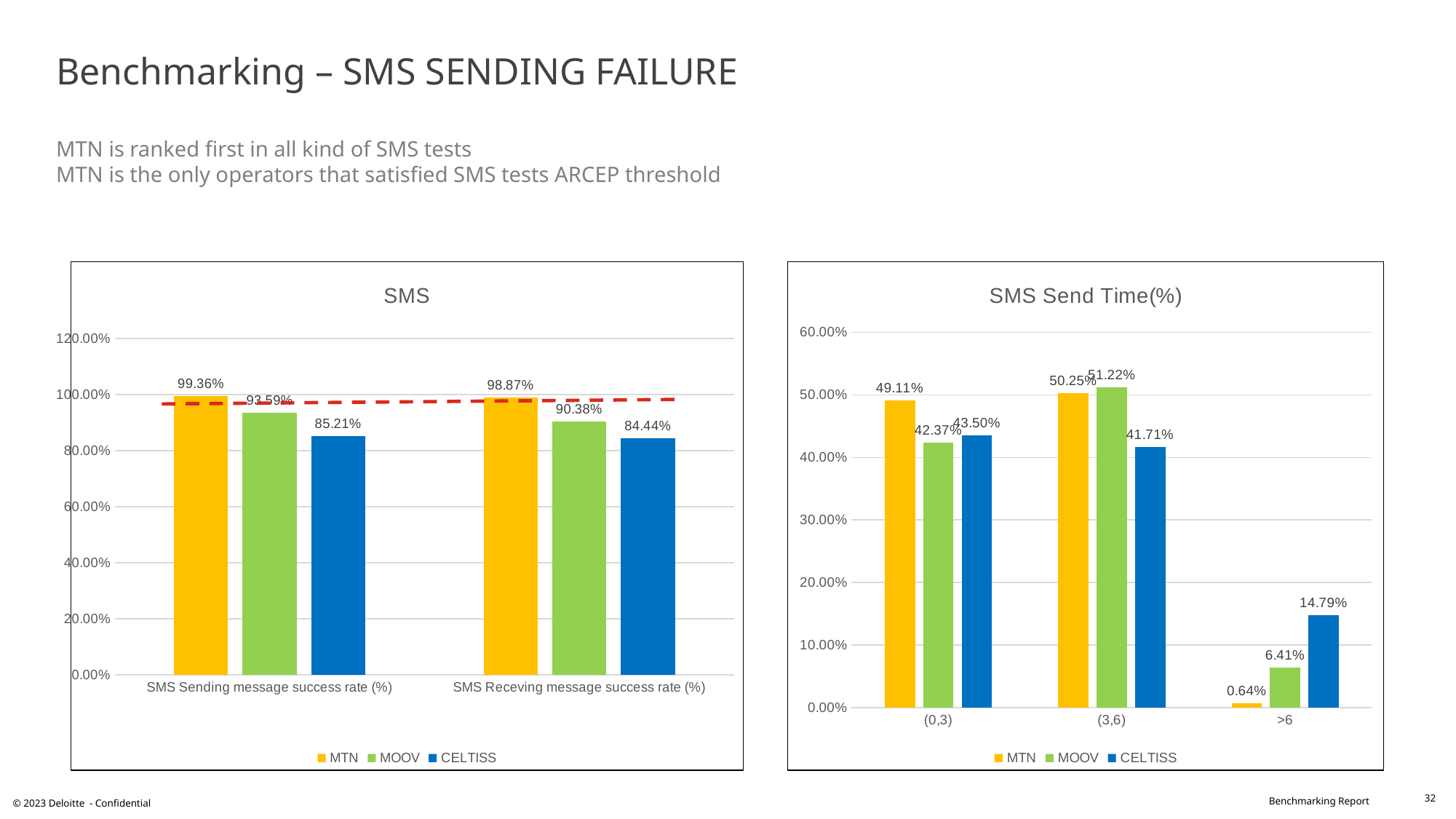
In the SMS Send Time(%) chart, what is the value for CELTISS in the >6 category? 14.79% In the SMS Send Time(%) chart, what is the value for MOOV in the (3,6) category? 51.22% In the SMS Send Time(%) chart, what is the difference between CELTISS's and MTN's values in the >6 category? 14.15% In the SMS chart, what is the SMS Receving message success rate (%) for CELTISS? 84.44% What kind of chart is the SMS Send Time(%) chart? Bar chart In the SMS chart, what is the SMS Sending message success rate (%) for MTN? 99.36% In the SMS Send Time(%) chart, which operator has the highest value in the (0,3) category? MTN In the SMS Send Time(%) chart, which is larger in the >6 category: MTN or MOOV? MOOV In the SMS chart, how many series does the legend list? 3 In the SMS chart, what is the difference between MTN's and MOOV's SMS Receving message success rate (%)? 8.49% In the SMS chart, which operator has the lowest SMS Sending message success rate (%)? CELTISS In the SMS Send Time(%) chart, how many categories are shown on the x axis? 3